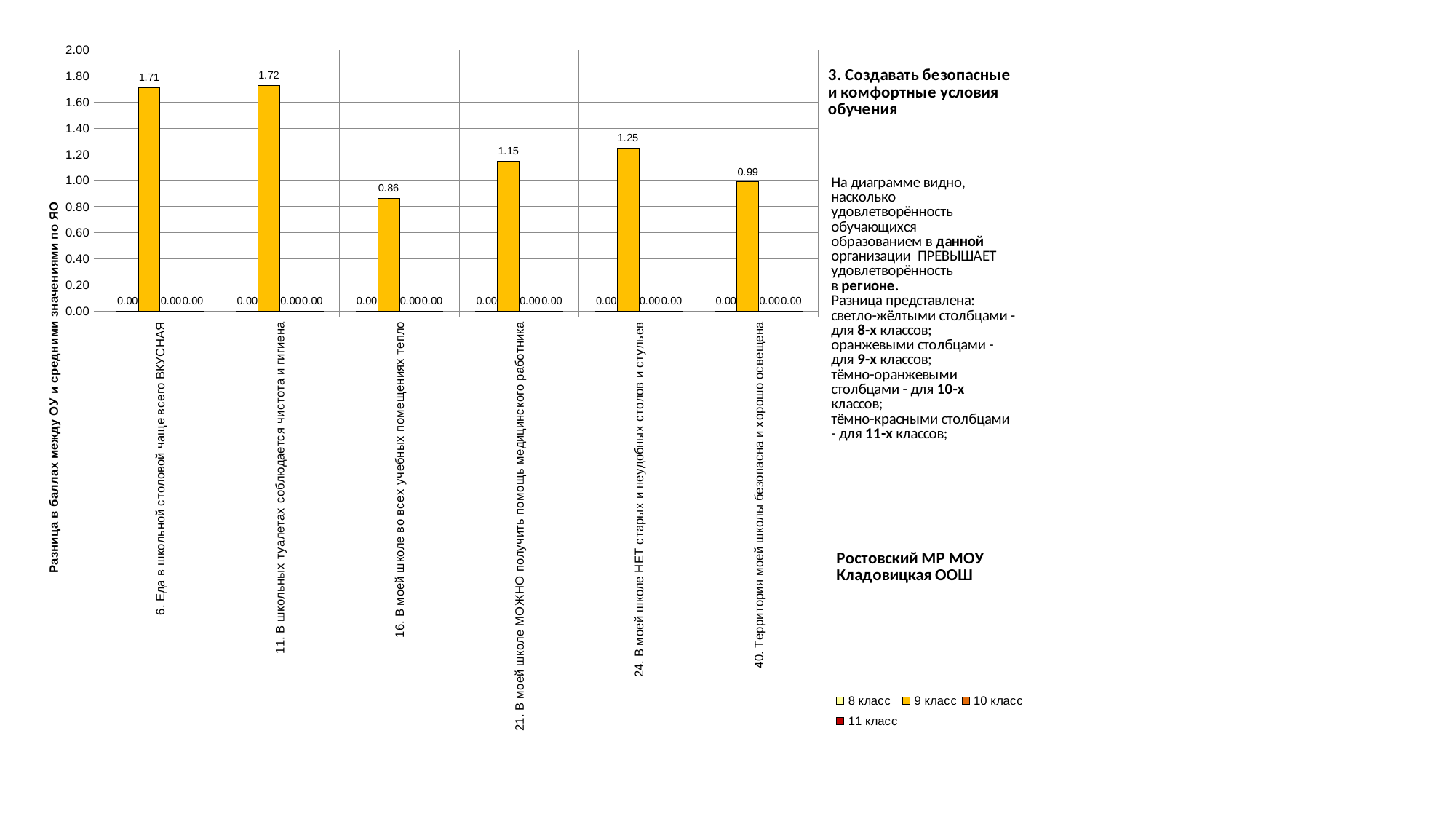
How many series does the legend list? 4 What is the value for 8 класс for the category "6. Еда в школьной столовой чаще всего ВКУСНАЯ"? 0.00 What is the value for 9 класс for the category "16. В моей школе во всех учебных помещениях тепло"? 0.86 Is the 9 класс value for "11. В школьных туалетах соблюдается чистота и гигиена" greater or less than 1.00? greater What is the value for 9 класс for the category "6. Еда в школьной столовой чаще всего ВКУСНАЯ"? 1.71 How many categories are shown on the x axis of the chart? 6 Which category has the lowest value for 9 класс? 16. В моей школе во всех учебных помещениях тепло What is the value for 9 класс for the category "40. Территория моей школы безопасна и хорошо освещена"? 0.99 What is the difference between the 9 класс values for "24. В моей школе НЕТ старых и неудобных столов и стульев" and "16. В моей школе во всех учебных помещениях тепло"? 0.39 What is the value for 9 класс for the category "24. В моей школе НЕТ старых и неудобных столов и стульев"? 1.25 Which has the larger 9 класс value: "21. В моей школе МОЖНО получить помощь медицинского работника" or "40. Территория моей школы безопасна и хорошо освещена"? 21. В моей школе МОЖНО получить помощь медицинского работника What kind of chart is shown on the slide? bar chart